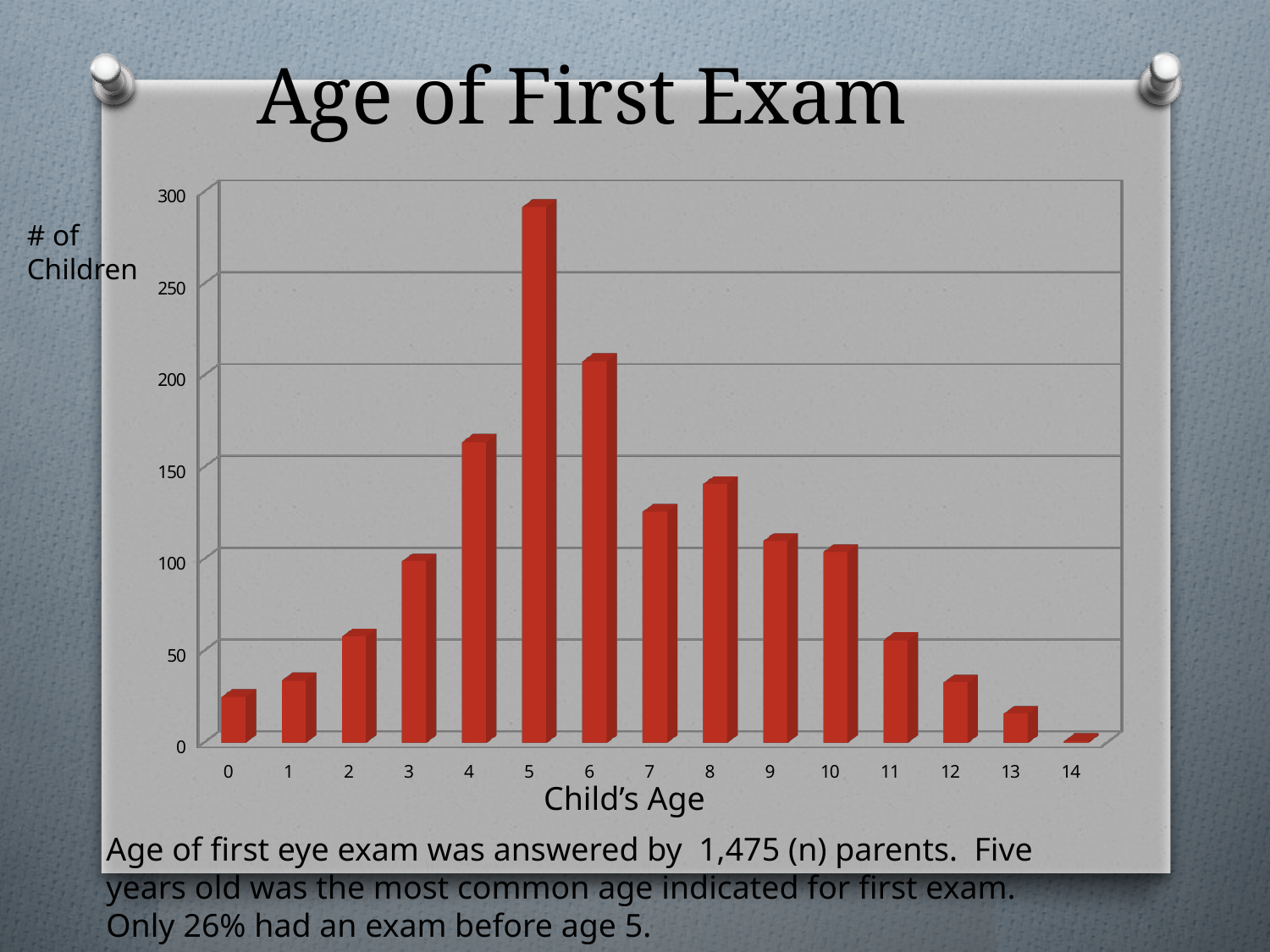
Is the value for age 5 greater or less than 250? greater Which has more children: age 3 or age 11? 3 What is the title of the chart? Age of First Exam Which child's age has the highest number of children for first exam? 5 Is the value for age 4 greater or less than 150? greater Is the value for age 6 greater or less than 200? greater What kind of chart is shown on the slide? bar chart Which has more children: age 6 or age 4? 6 Which child's age has the lowest number of children for first exam? 14 How many age categories are shown on the x axis? 15 Do the values rise or fall from age 5 to age 14? fall